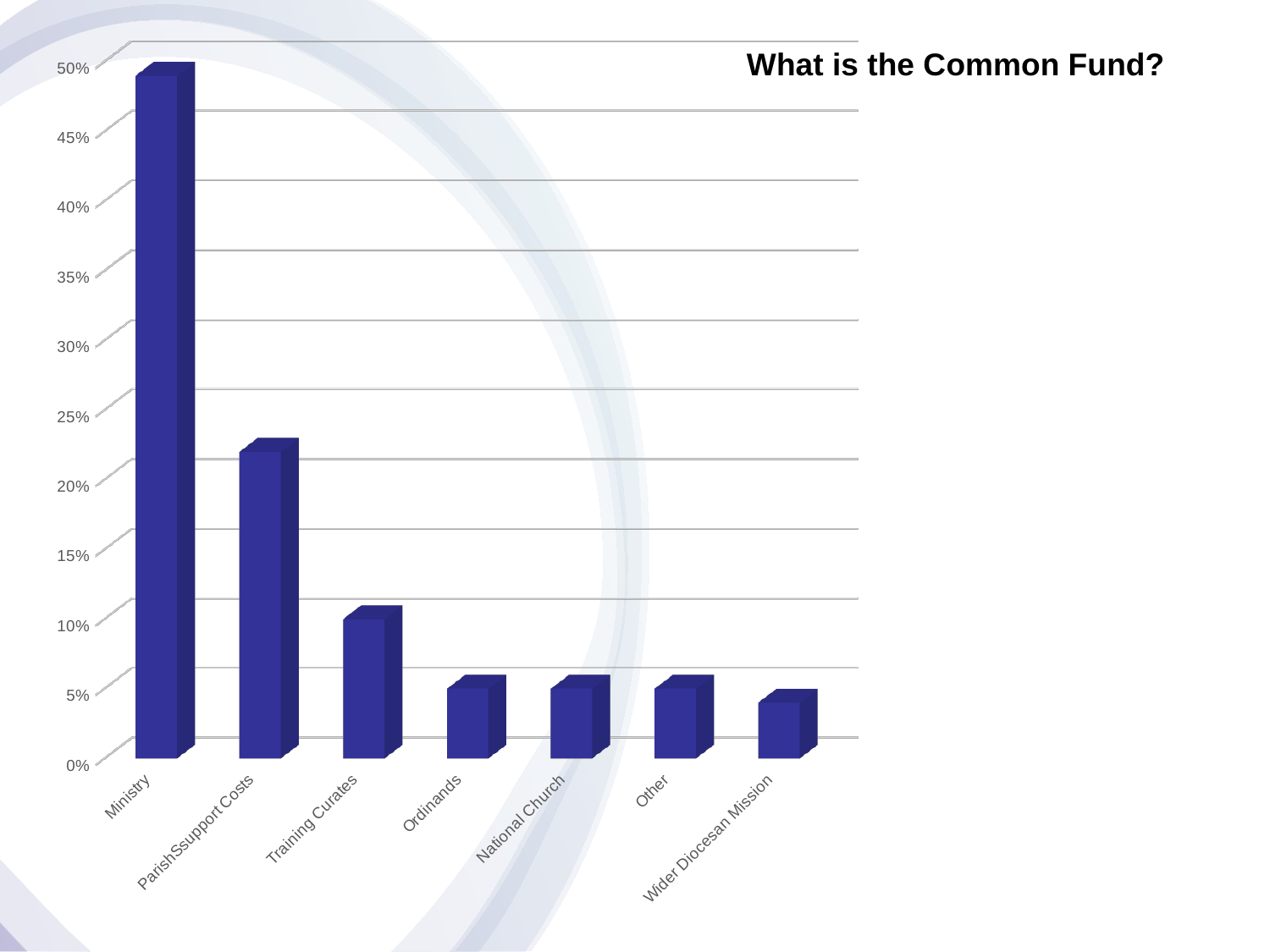
Is the value for Training Curates greater or less than 15%? less What is the title shown on the slide? What is the Common Fund? Which is larger, the value for Training Curates or the value for Other? Training Curates Is the value for Ordinands greater or less than 10%? less How many categories are plotted on the chart? 7 Is the value for Ministry greater or less than 45%? greater What kind of chart is shown on the slide? bar chart Which is larger, the value for Ministry or the value for ParishSsupport Costs? Ministry Do the values generally rise or fall moving from left to right along the x axis? fall Which category has the highest value? Ministry